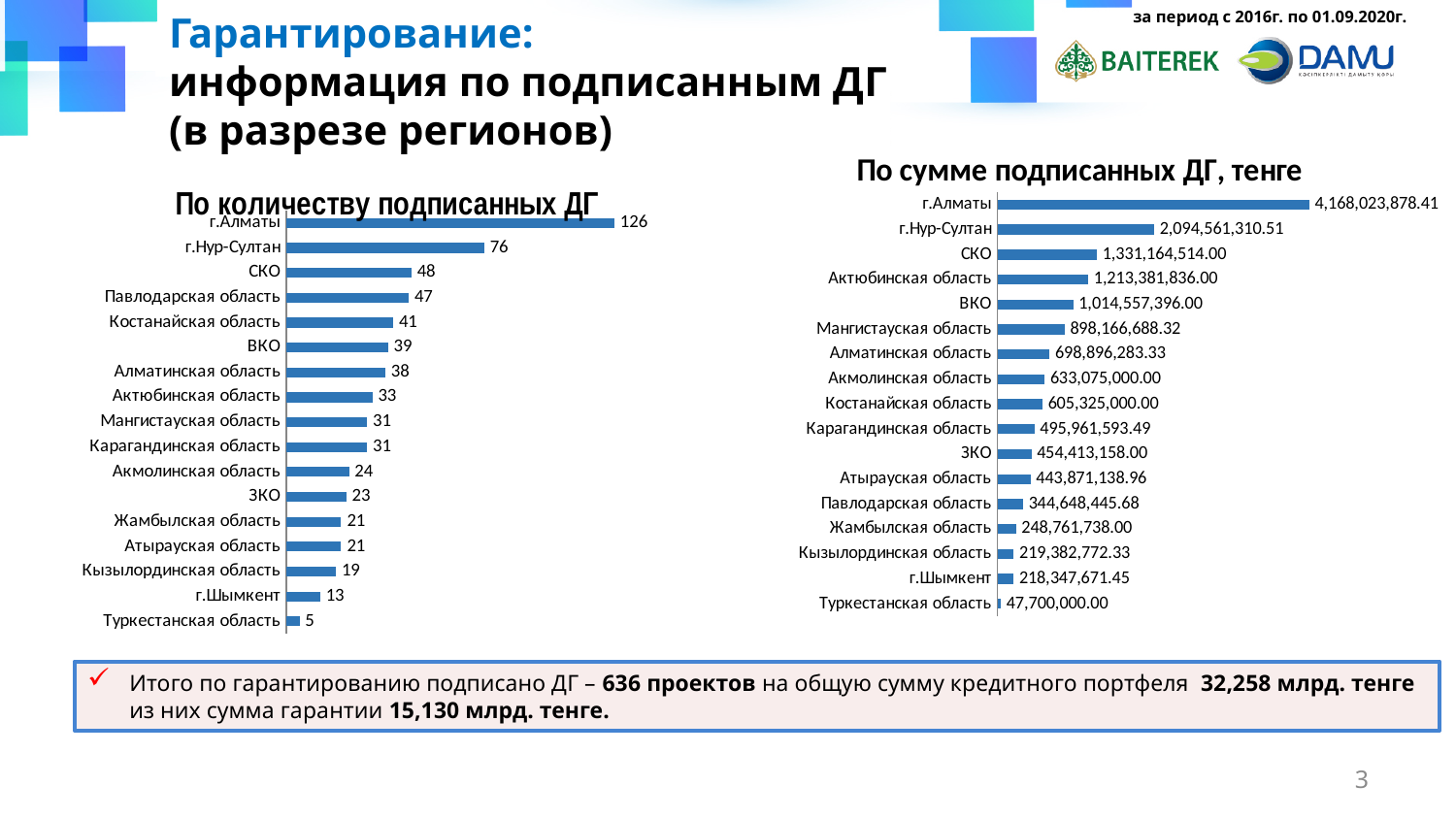
In the chart 'По количеству подписанных ДГ', what is the value for г.Нур-Султан? 76 In the chart 'По сумме подписанных ДГ, тенге', what is the value for Туркестанская область? 47,700,000.00 In the chart 'По сумме подписанных ДГ, тенге', what is the value for СКО? 1,331,164,514.00 In the chart 'По количеству подписанных ДГ', what is the value for Кызылординская область? 19 In the chart 'По количеству подписанных ДГ', which region has the highest value? г.Алматы In the chart 'По количеству подписанных ДГ', how many regions are shown? 17 In the chart 'По количеству подписанных ДГ', which region has the lowest value? Туркестанская область In the chart 'По сумме подписанных ДГ, тенге', which region has the highest value? г.Алматы In the chart 'По сумме подписанных ДГ, тенге', what is the value for г.Шымкент? 218,347,671.45 In the chart 'По сумме подписанных ДГ, тенге', which is larger: Актюбинская область or ВКО? Актюбинская область In the chart 'По количеству подписанных ДГ', what is the difference between г.Алматы and г.Нур-Султан? 50 What type of chart is 'По сумме подписанных ДГ, тенге'? Bar chart